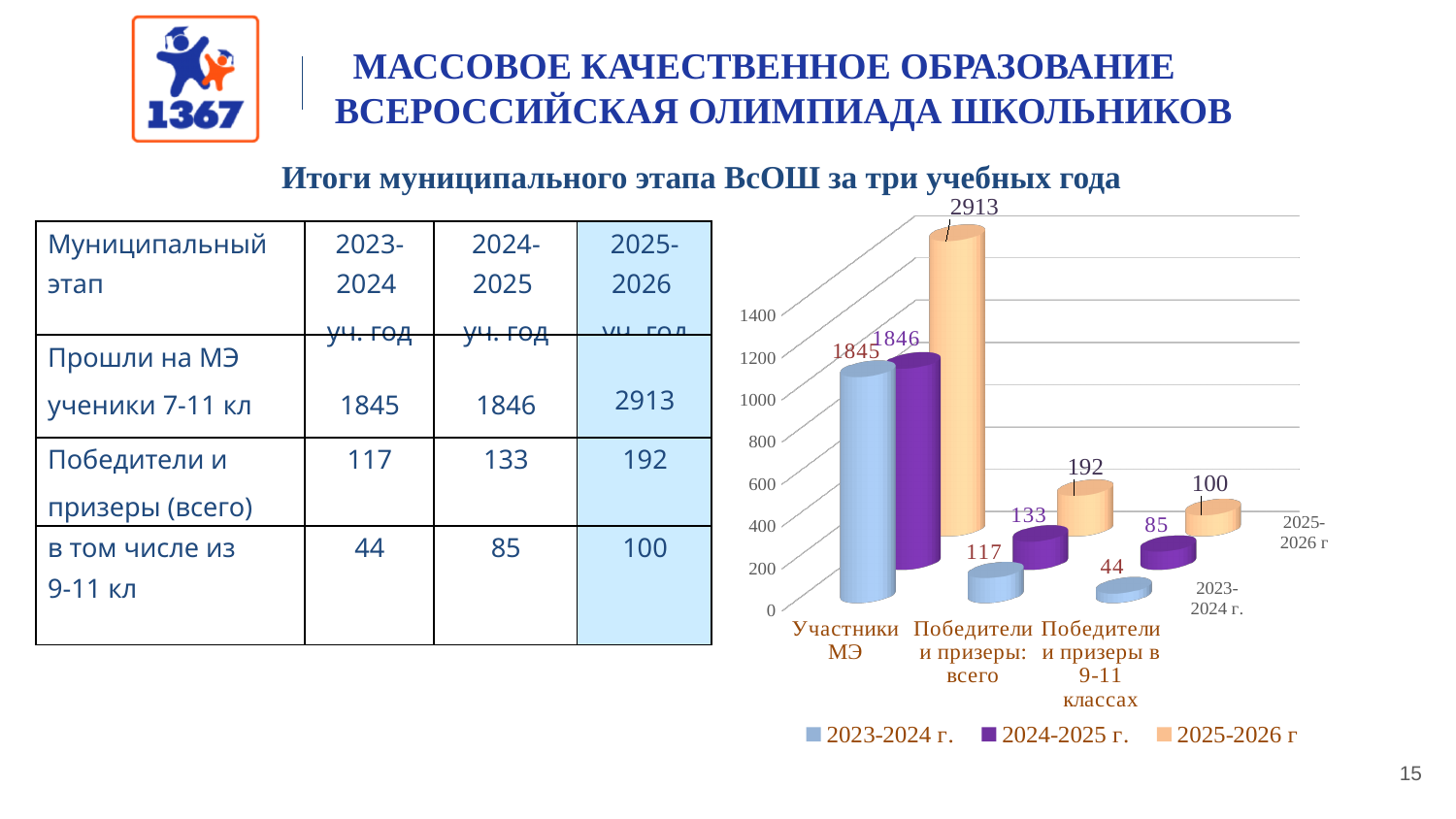
Which series has the lowest value for Победители и призеры в 9-11 классах? 2023-2024 г. What is the value for Победители и призеры в 9-11 классах in the 2023-2024 г. series? 44 Which series is shown in purple in the chart legend? 2024-2025 г. How many series does the chart legend list? 3 What is the value for Участники МЭ in the 2025-2026 г series? 2913 Which series has the highest value for Участники МЭ? 2025-2026 г What is the difference between the 2025-2026 г and 2023-2024 г. values for Участники МЭ? 1068 What is the value for Победители и призеры: всего in the 2024-2025 г. series? 133 What is the difference between the 2025-2026 г and 2024-2025 г. values for Победители и призеры: всего? 59 How many categories are shown on the x axis of the chart? 3 What kind of chart is shown on the slide? bar chart Which is larger: the 2024-2025 г. value for Победители и призеры в 9-11 классах or the 2023-2024 г. value for the same category? 2024-2025 г.